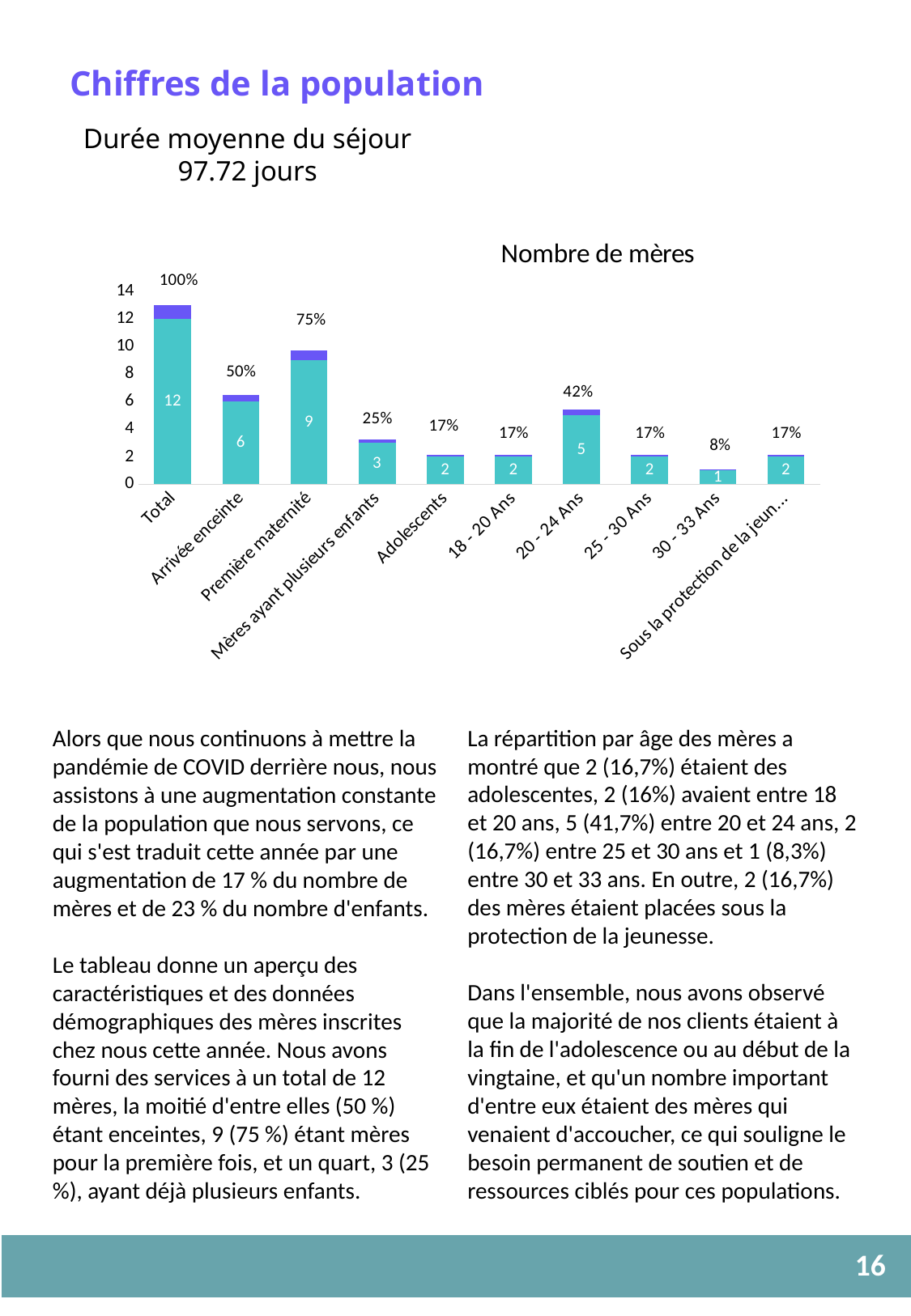
Which category has the lowest number of mothers? 30 - 33 Ans What percentage is shown above the '20 - 24 Ans' bar? 42% What percentage is shown above the '30 - 33 Ans' bar? 8% What is the number of mothers for 'Arrivée enceinte'? 6 What is the number of mothers for 'Adolescents'? 2 Which category has the highest number of mothers? Total What is the title of the chart? Nombre de mères Which has more mothers, 'Mères ayant plusieurs enfants' or '20 - 24 Ans'? 20 - 24 Ans How many categories are shown on the x axis of the chart? 10 What is the number of mothers for 'Première maternité'? 9 What is the difference between the number of mothers for 'Total' and for 'Arrivée enceinte'? 6 What kind of chart is shown on the slide? bar chart